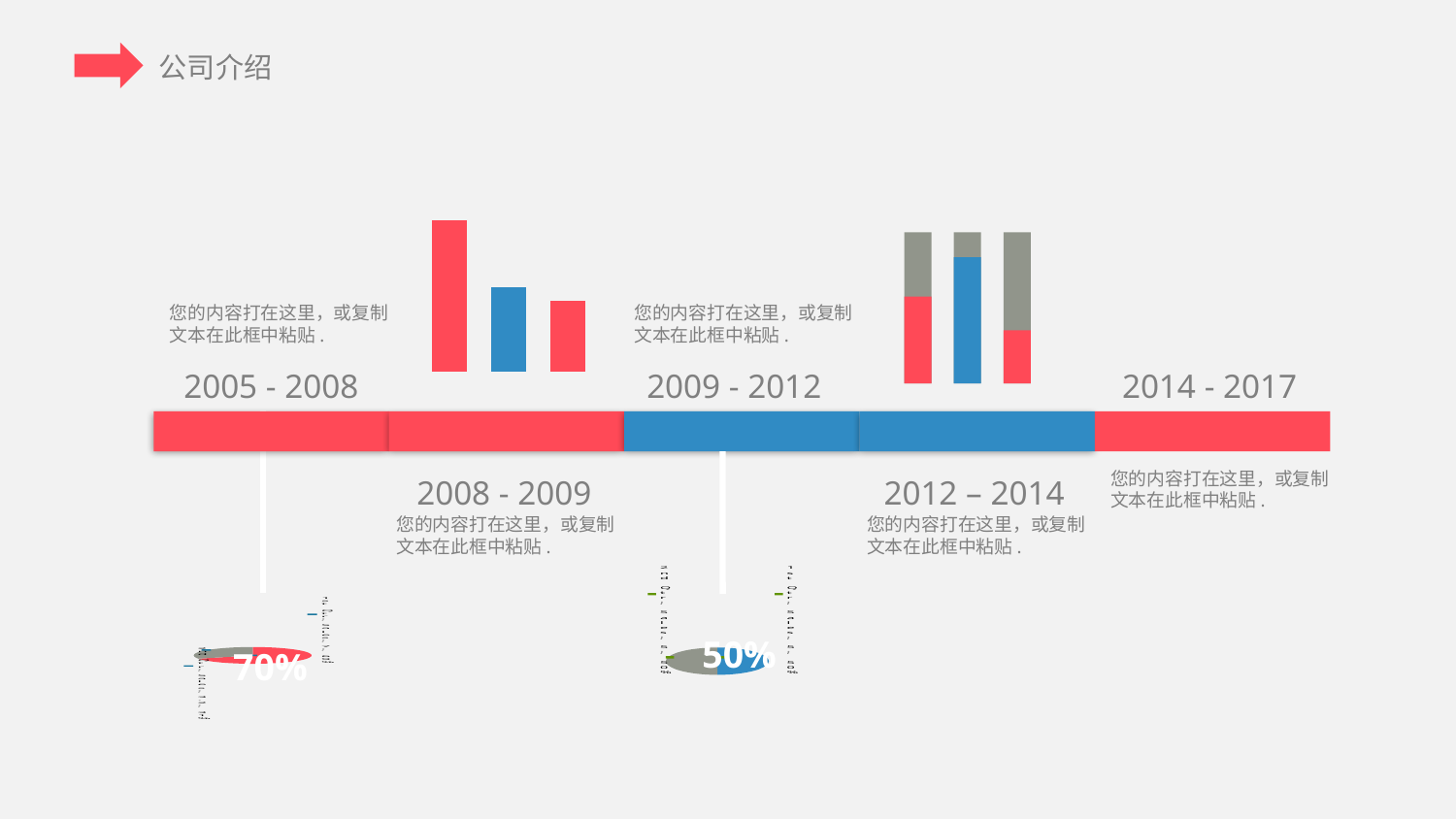
In the bar chart above the 2008 - 2009 section of the timeline, which bar is the tallest: the leftmost, middle, or rightmost? leftmost In the bar chart above the 2008 - 2009 section of the timeline, is the leftmost bar taller or shorter than the middle bar? taller In the bar chart above the 2008 - 2009 section of the timeline, what colour is the middle bar? blue What kind of chart is shown above the 2005 - 2008 / 2008 - 2009 section of the timeline? bar chart What kind of chart is shown above the 2012 – 2014 section of the timeline? stacked bar chart How many bars does the stacked bar chart above the 2012 – 2014 section of the timeline have? 3 What percentage is printed on the pie chart at the bottom centre of the slide, below the 2009 - 2012 label? 50% In the stacked bar chart above the 2012 – 2014 section of the timeline, which bar has the largest blue segment: the leftmost, middle, or rightmost? middle How many bars does the bar chart above the 2008 - 2009 section of the timeline have? 3 What percentage is printed on the pie chart at the bottom left of the slide, below the 2005 - 2008 label? 70% What kind of chart is shown at the bottom left of the slide, below the 2005 - 2008 label? pie chart In the bar chart above the 2008 - 2009 section of the timeline, which bar is the shortest: the leftmost, middle, or rightmost? rightmost